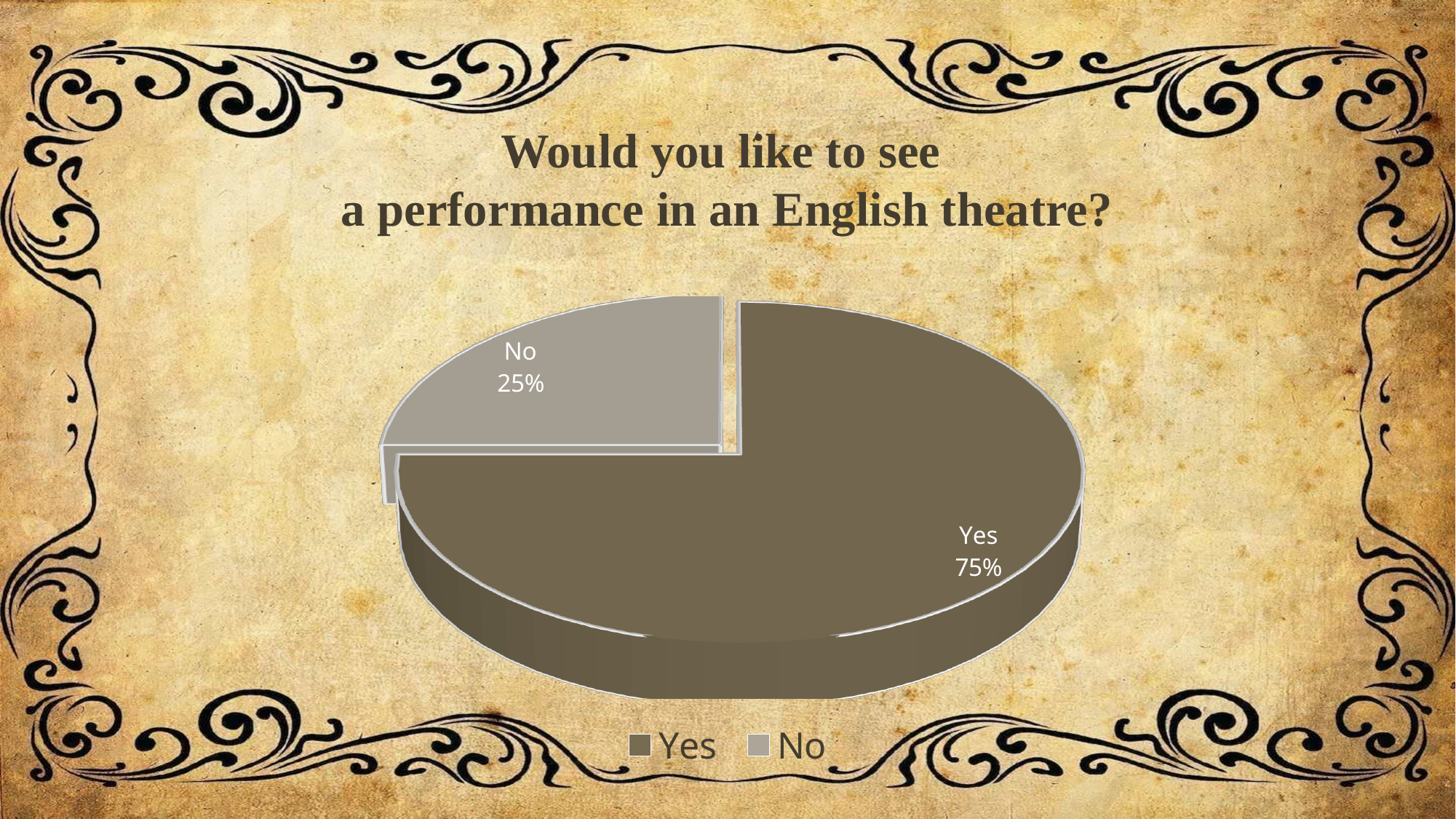
What is the title of the chart? Would you like to see a performance in an English theatre? What kind of chart is shown on the slide? pie chart Which slice is the smallest in the pie chart? No Which slice is shown in the lighter grey colour? No Which slice is the largest in the pie chart? Yes How many slices does the pie chart have? 2 What is the difference in percentage points between the "Yes" and "No" slices? 50% How many entries does the legend list? 2 What share of the pie does the "Yes" slice represent? 75% Which is larger, the "Yes" slice or the "No" slice? Yes What share of the pie does the "No" slice represent? 25%